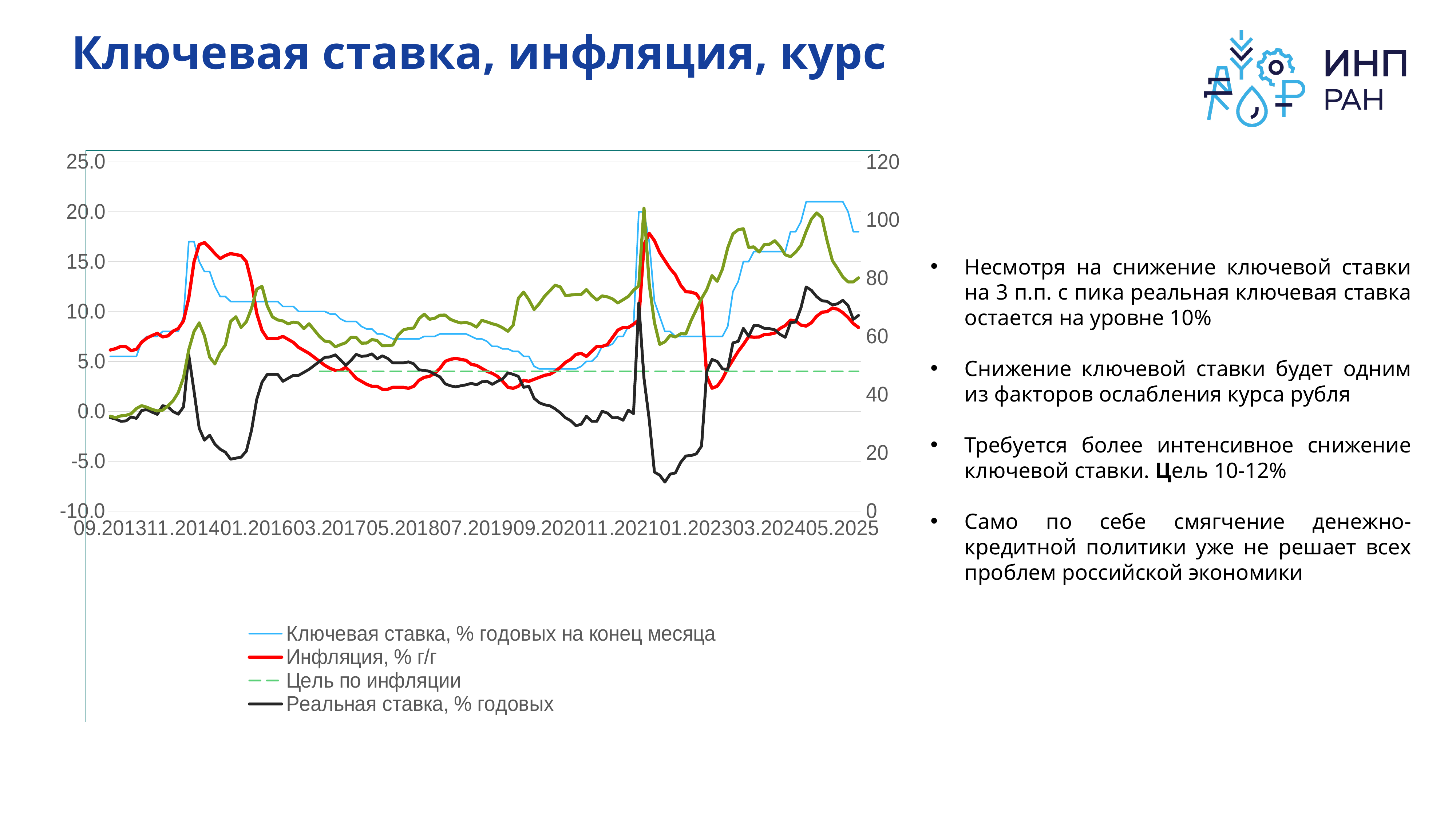
Which series in the legend reaches the lowest value on the left axis? Реальная ставка, % годовых What kind of chart is shown on the slide? line chart At 05.2025, which is larger: 'Ключевая ставка, % годовых на конец месяца' or 'Инфляция, % г/г'? Ключевая ставка, % годовых на конец месяца Is the peak value of 'Ключевая ставка, % годовых на конец месяца' greater or less than 20.0? greater What is the highest value shown on the left vertical axis? 25.0 How many date labels are shown on the x axis? 11 Is the value of 'Ключевая ставка, % годовых на конец месяца' at 05.2025 greater or less than 15? greater Is the lowest value reached by 'Реальная ставка, % годовых' greater or less than -5.0? less Does 'Инфляция, % г/г' rise or fall between 01.2023 and 05.2025? fall Which series in the legend is drawn as a dashed line? Цель по инфляции How many series does the chart legend list? 4